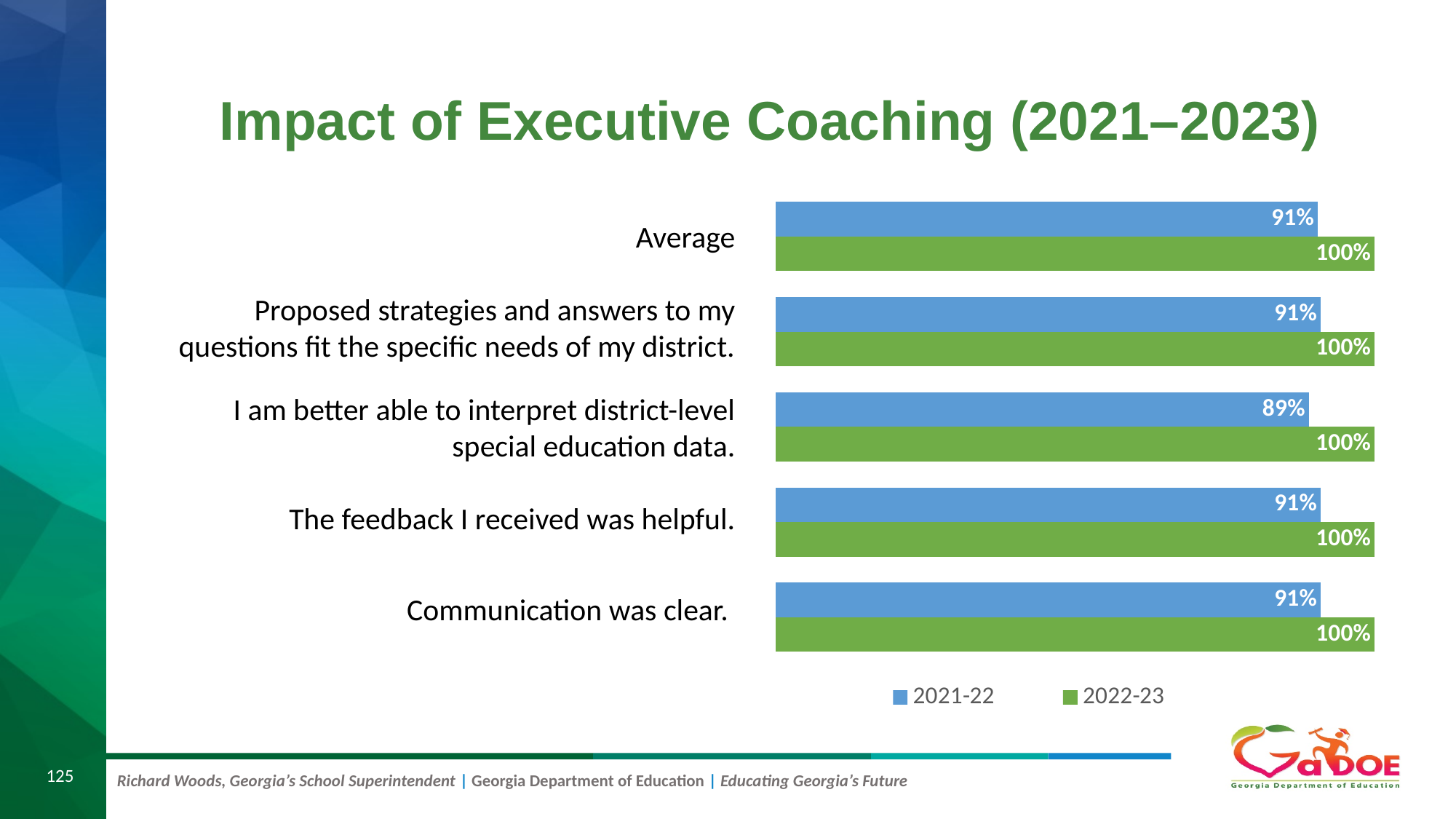
How many categories are shown on the chart? 5 How many series does the legend list? 2 What is the 2021-22 value for "Communication was clear."? 91% Which colour represents the 2022-23 series? Green What is the 2022-23 value for "The feedback I received was helpful."? 100% Which category has the lowest 2021-22 value? I am better able to interpret district-level special education data. What is the difference between the 2022-23 and 2021-22 values for "Average"? 9% What kind of chart is shown on the slide? Bar chart What is the 2021-22 value for "Average"? 91% What is the difference between the 2022-23 and 2021-22 values for "I am better able to interpret district-level special education data."? 11% Which is larger for "Proposed strategies and answers to my questions fit the specific needs of my district.": the 2021-22 value or the 2022-23 value? 2022-23 What is the 2021-22 value for "I am better able to interpret district-level special education data."? 89%